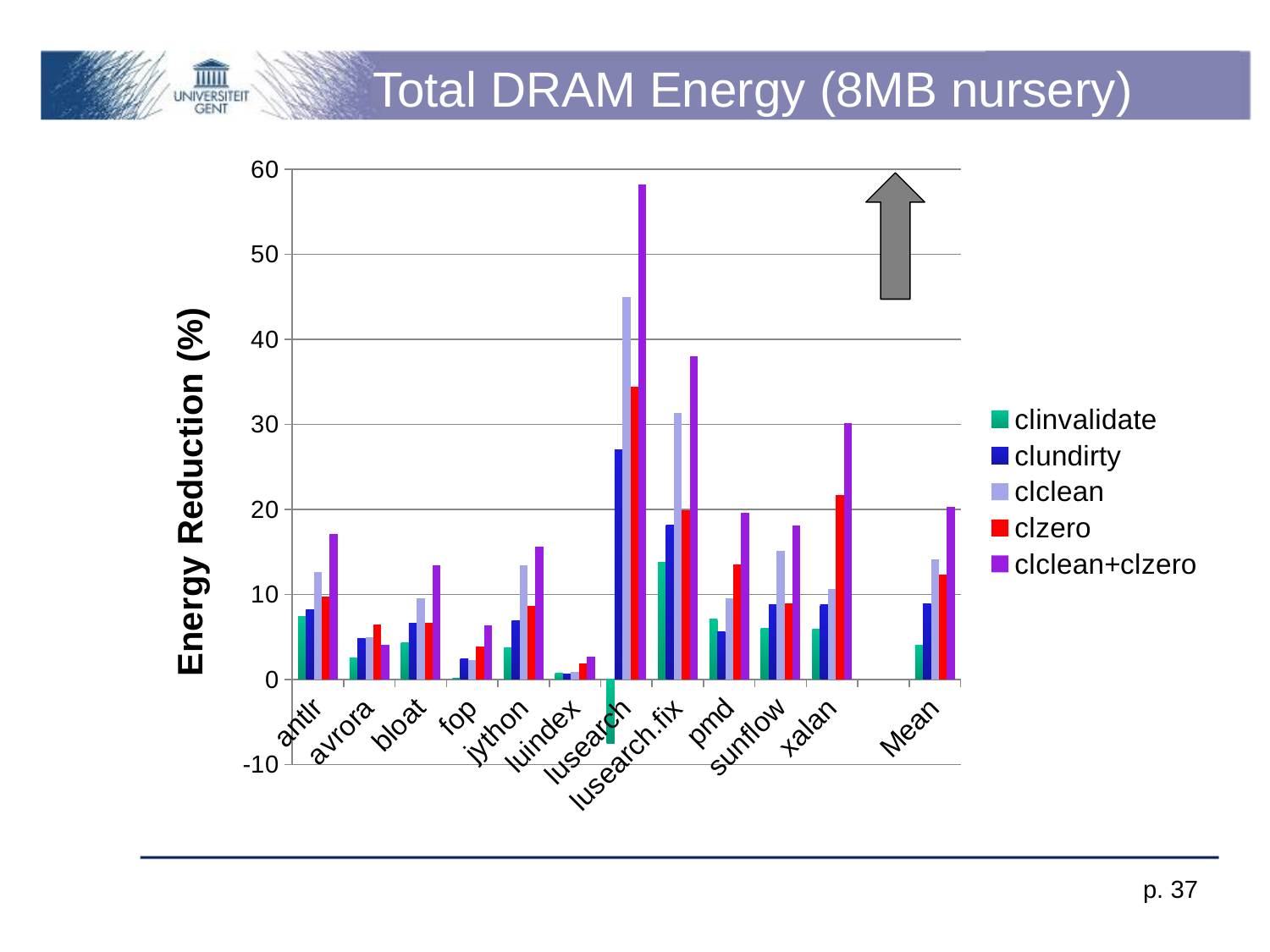
Is the clzero value for Mean greater or less than 10? greater Which category has the lowest clclean+clzero value? luindex Is the clclean value for lusearch greater or less than 40? greater Is the clclean+clzero value for lusearch greater or less than 50? greater What is the label on the y axis? Energy Reduction (%) Which series has the lowest value for lusearch? clinvalidate What kind of chart is shown on the slide? bar chart How many categories are shown along the x axis? 12 Which category has the highest clclean+clzero value? lusearch For xalan, which is larger: the clzero value or the clclean value? clzero How many series does the legend list? 5